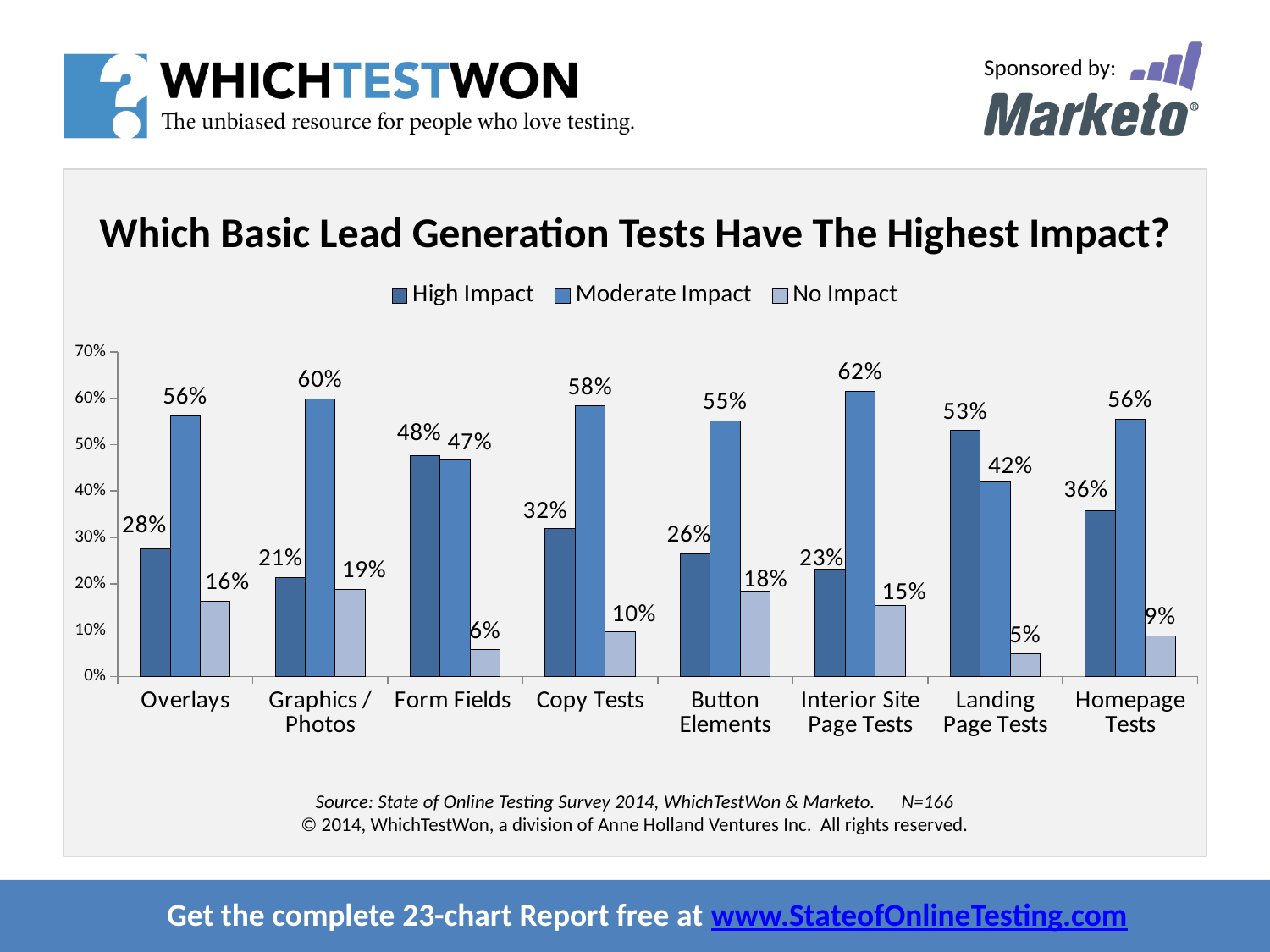
What is the No Impact value for Form Fields? 6% What is the High Impact value for Landing Page Tests? 53% Is the High Impact value for Form Fields greater or less than 40%? greater Which category has the lowest No Impact value? Landing Page Tests What is the Moderate Impact value for Interior Site Page Tests? 62% Which is larger for Homepage Tests: the High Impact value or the Moderate Impact value? Moderate Impact How many test categories are shown on the x axis? 8 How many series does the legend list? 3 Which category has the highest Moderate Impact value? Interior Site Page Tests What kind of chart is shown on the slide? Bar chart What is the difference between the Moderate Impact and High Impact values for Copy Tests? 26% What is the title of the chart? Which Basic Lead Generation Tests Have The Highest Impact?